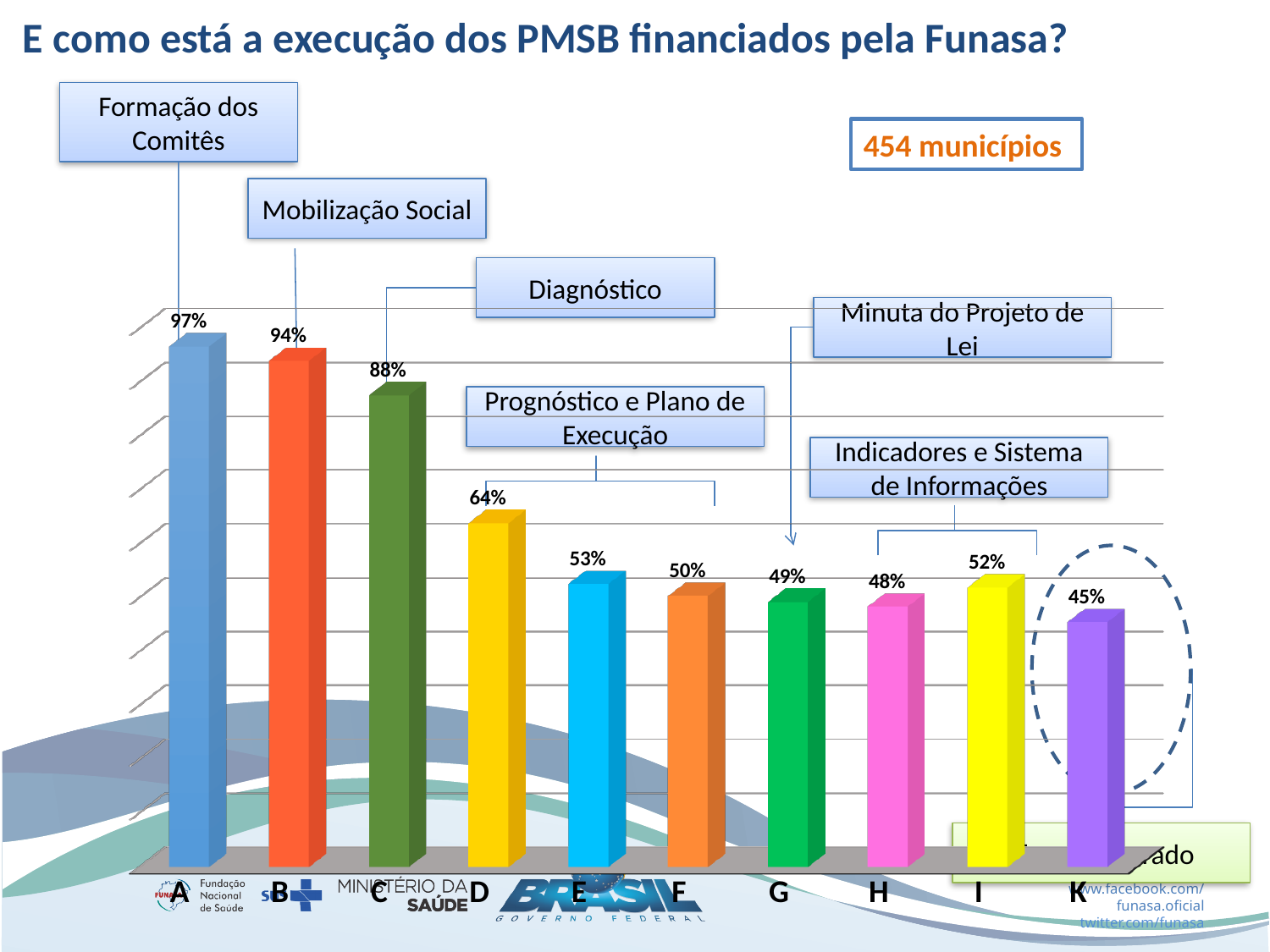
How many bars are plotted in the chart? 10 What is the value for category A? 97% Which category has the highest value? A What kind of chart is shown on the slide? Bar chart What is the value for category K? 45% What is the value for category I? 52% What number of municipalities is stated in the box at the top right of the slide? 454 municípios Which category has the lowest value? K What is the value for category D? 64% What is the difference between the values for A and B? 3% What is the difference between the values for C and D? 24% Which is larger, the value for E or the value for F? E